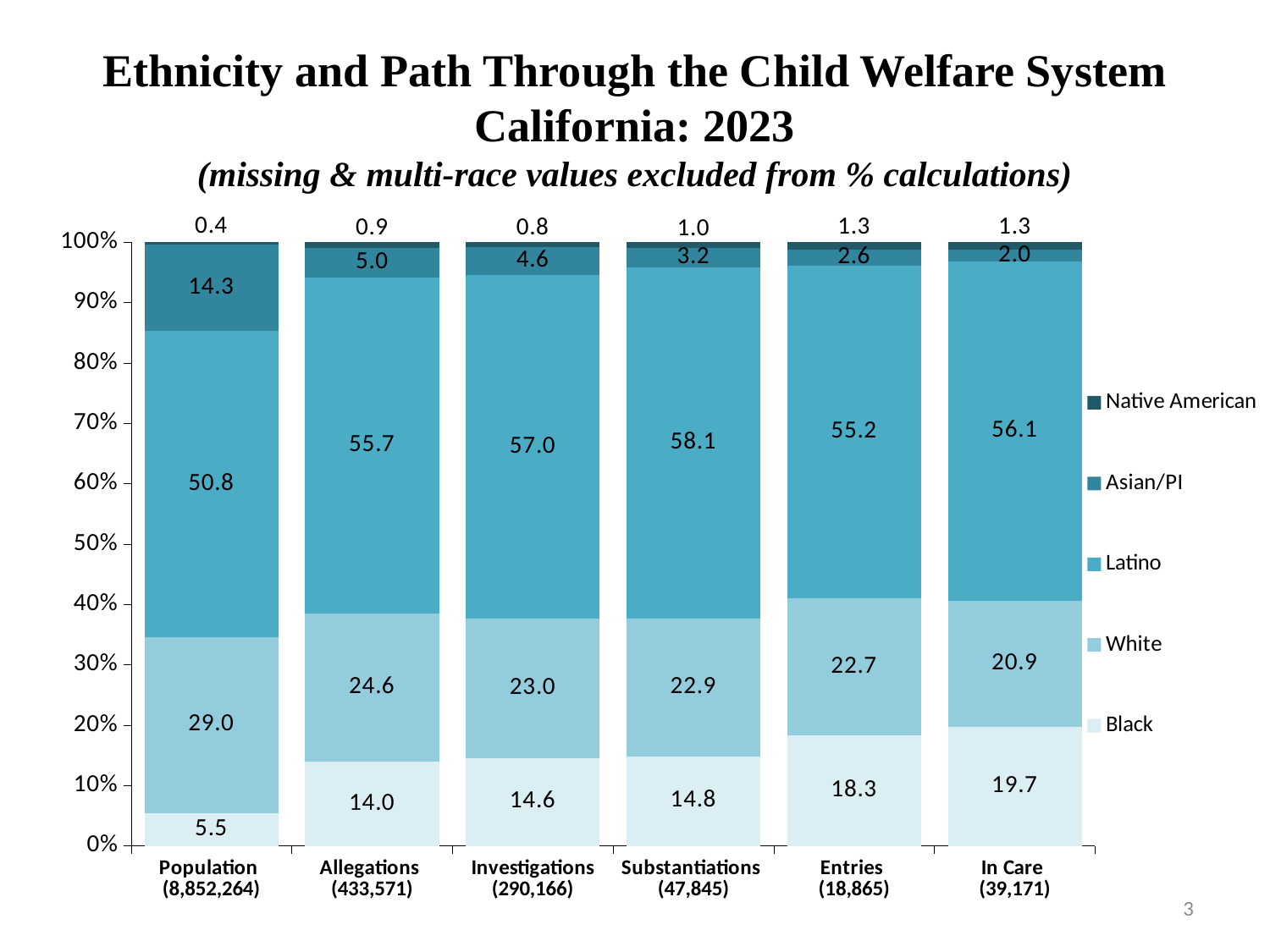
Which category has the highest Black share? In Care Does the Black share rise or fall from Population to In Care along the x axis? Rise What is the White share for In Care? 20.9 What is the Asian/PI share for Allegations? 5.0 Which category has the lowest Asian/PI share? In Care What is the Black share for the Population category? 5.5 What is the Latino share for Substantiations? 58.1 What kind of chart is shown on the slide? Stacked bar chart How many series does the legend list? 5 What is the difference between the Latino share for Substantiations and the Latino share for Population? 7.3 How many categories are shown along the x axis? 6 Is the White share larger for Population or for Entries? Population